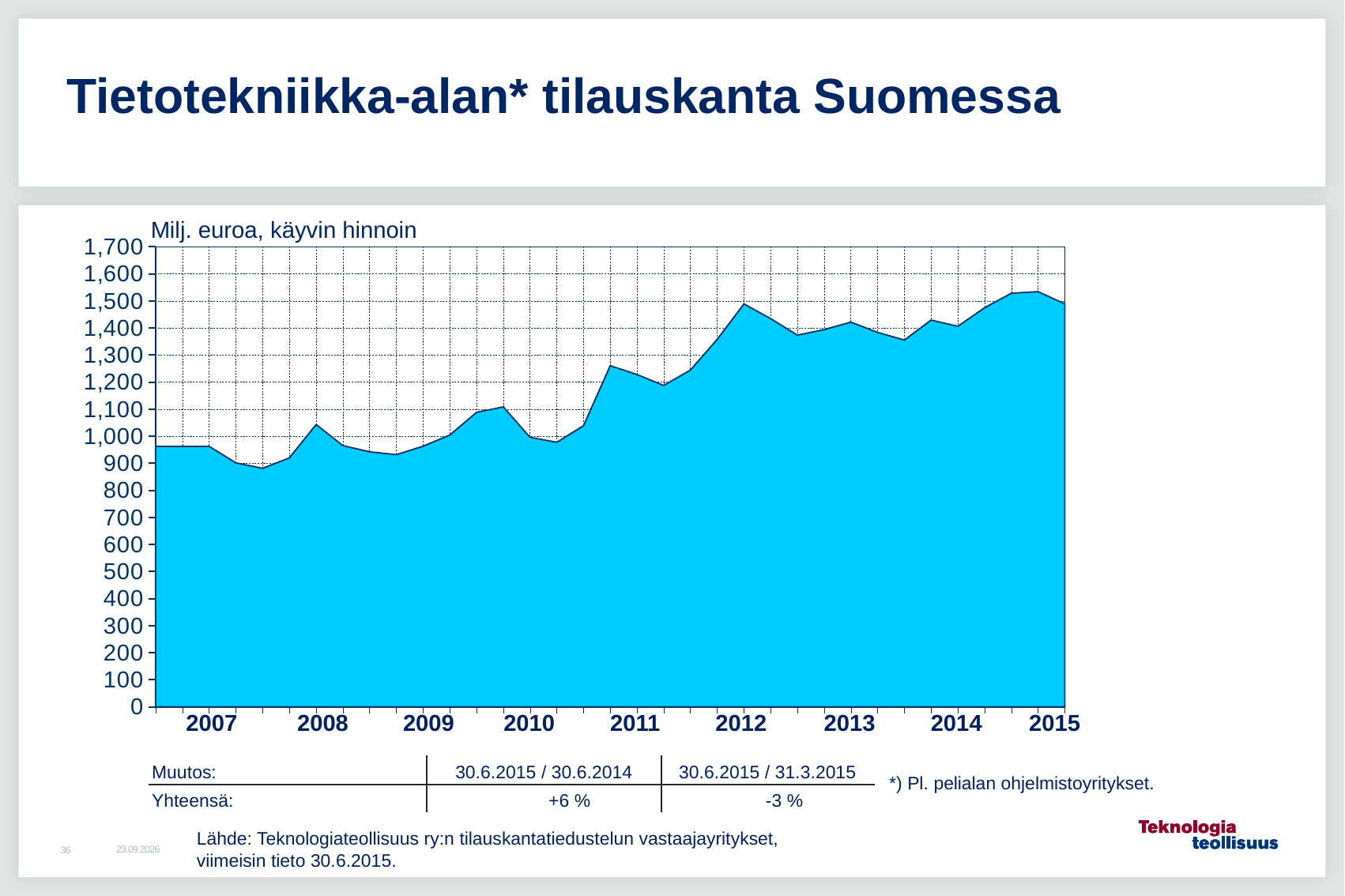
Is the peak value in 2012 greater or less than 1,400? greater Is the lowest value in 2007 greater or less than 900? less Which is larger, the value at the start of 2007 or the value at 2015? 2015 Overall, do the values rise or fall from 2007 to 2015? Rise In which year does the series reach its lowest point? 2007 What kind of chart is shown on the slide? Area chart Is the value at the 2015 end of the series greater or less than 1,400? greater How many year labels are shown on the x axis of the chart? 9 What is the title of the slide's chart? Tietotekniikka-alan* tilauskanta Suomessa What unit label is shown above the y axis of the chart? Milj. euroa, käyvin hinnoin